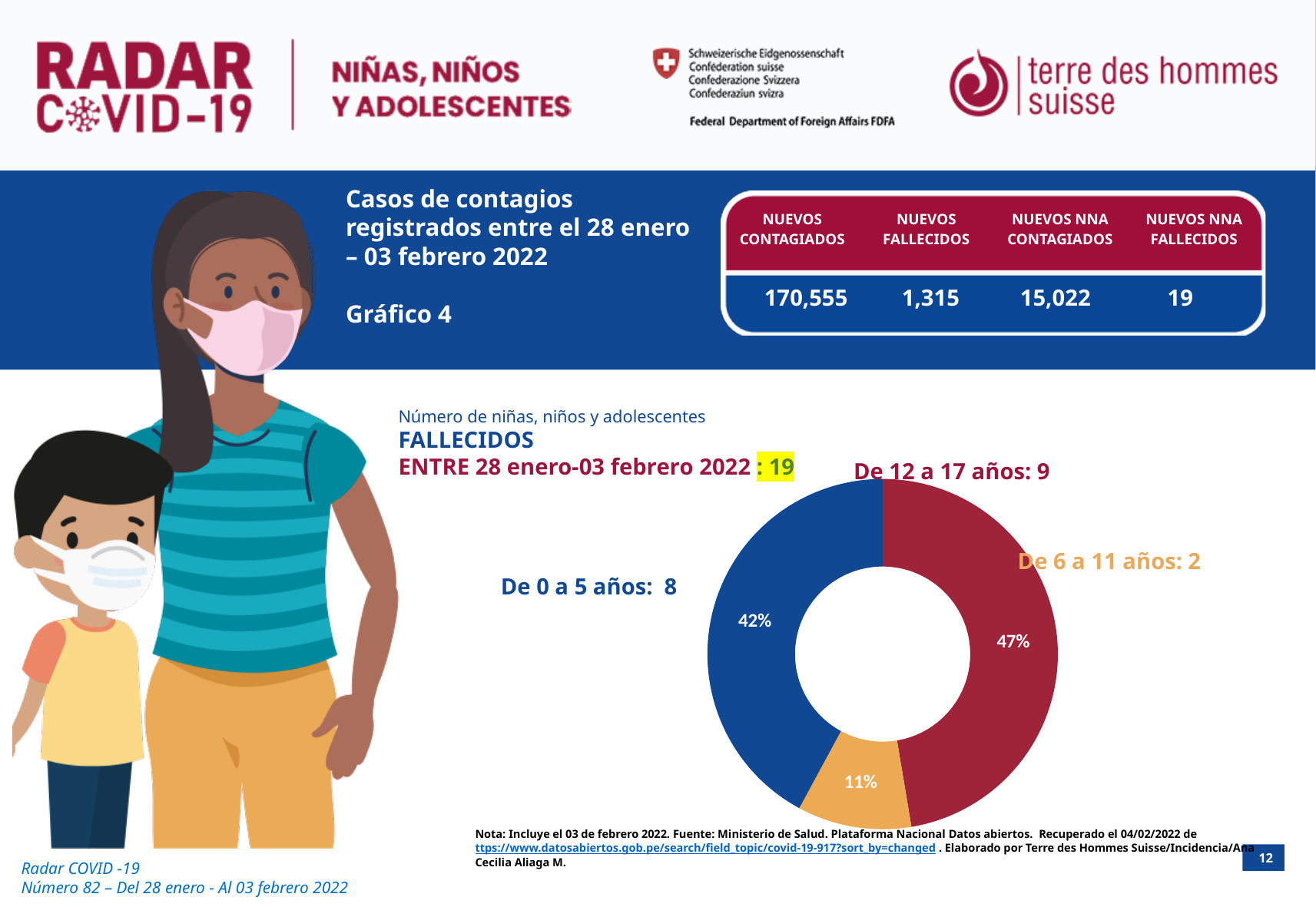
What is the difference in deaths between the 'De 12 a 17 años' group and the 'De 6 a 11 años' group? 7 What percentage of the pie chart does the 'De 6 a 11 años' group represent? 11% What kind of chart is shown on the slide? doughnut chart Which group has more deaths, 'De 0 a 5 años' or 'De 12 a 17 años'? De 12 a 17 años What is the total number of deaths shown across all age groups in the pie chart? 19 How many age groups are shown in the pie chart? 3 Which age group has the largest share of the pie chart? De 12 a 17 años What percentage of the pie chart does the 'De 0 a 5 años' group represent? 42% How many deaths are shown for the 'De 0 a 5 años' group? 8 Which age group has the smallest share of the pie chart? De 6 a 11 años How many deaths are shown for the 'De 12 a 17 años' group? 9 How many deaths are shown for the 'De 6 a 11 años' group? 2